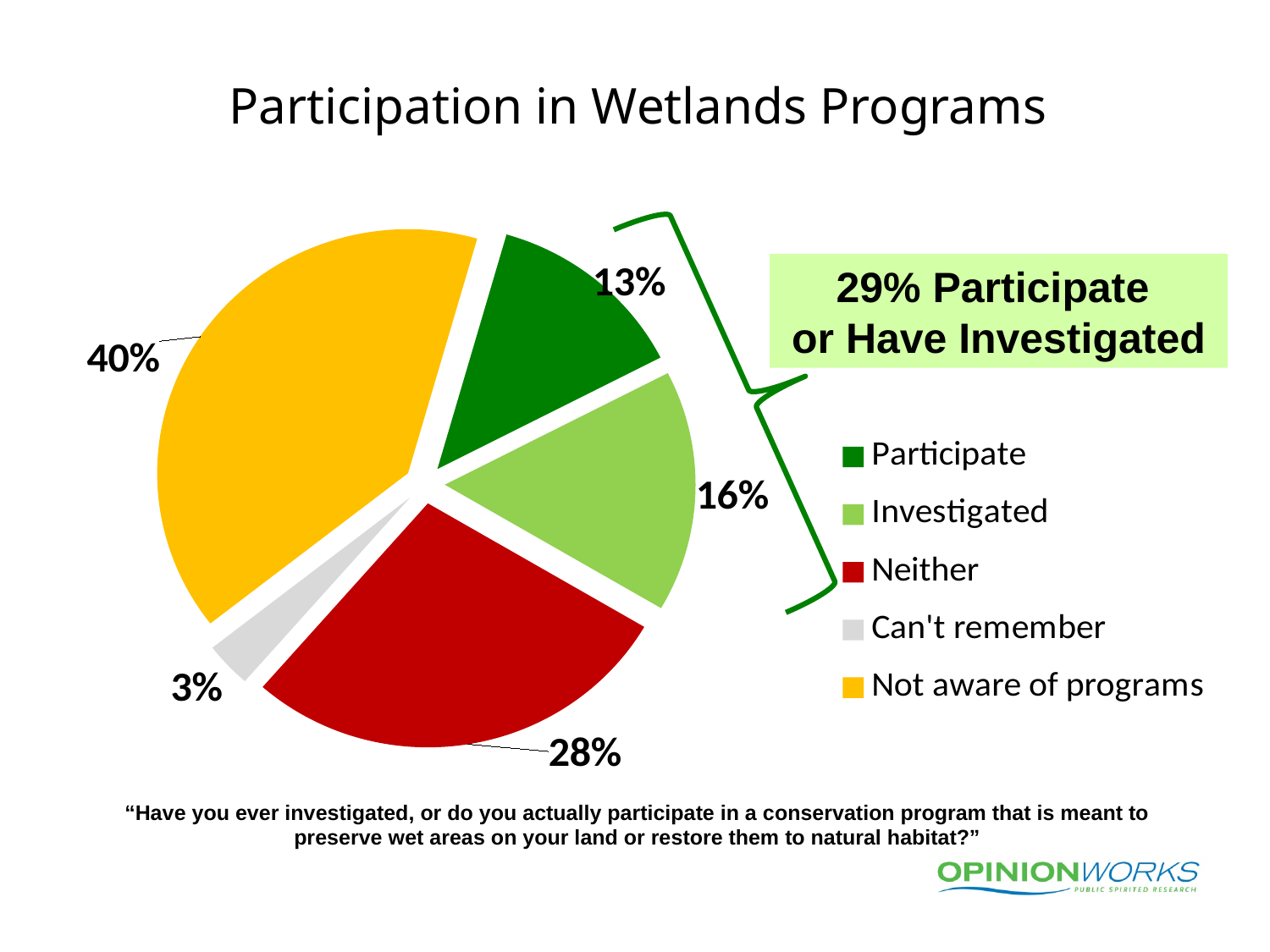
What percentage of respondents said they Can't remember? 3% What type of chart is shown on the slide? Pie chart Which category has the smallest share of the pie? Can't remember Which is larger, the share for Investigated or the share for Participate? Investigated What percentage of respondents answered Neither? 28% What percentage of respondents were Not aware of programs? 40% What is the title of the chart? Participation in Wetlands Programs What percentage of respondents said they had Investigated? 16% What is the difference in percentage points between Not aware of programs and Neither? 12 How many categories does the pie chart show? 5 Which category has the largest share of the pie? Not aware of programs What percentage of respondents said they Participate? 13%